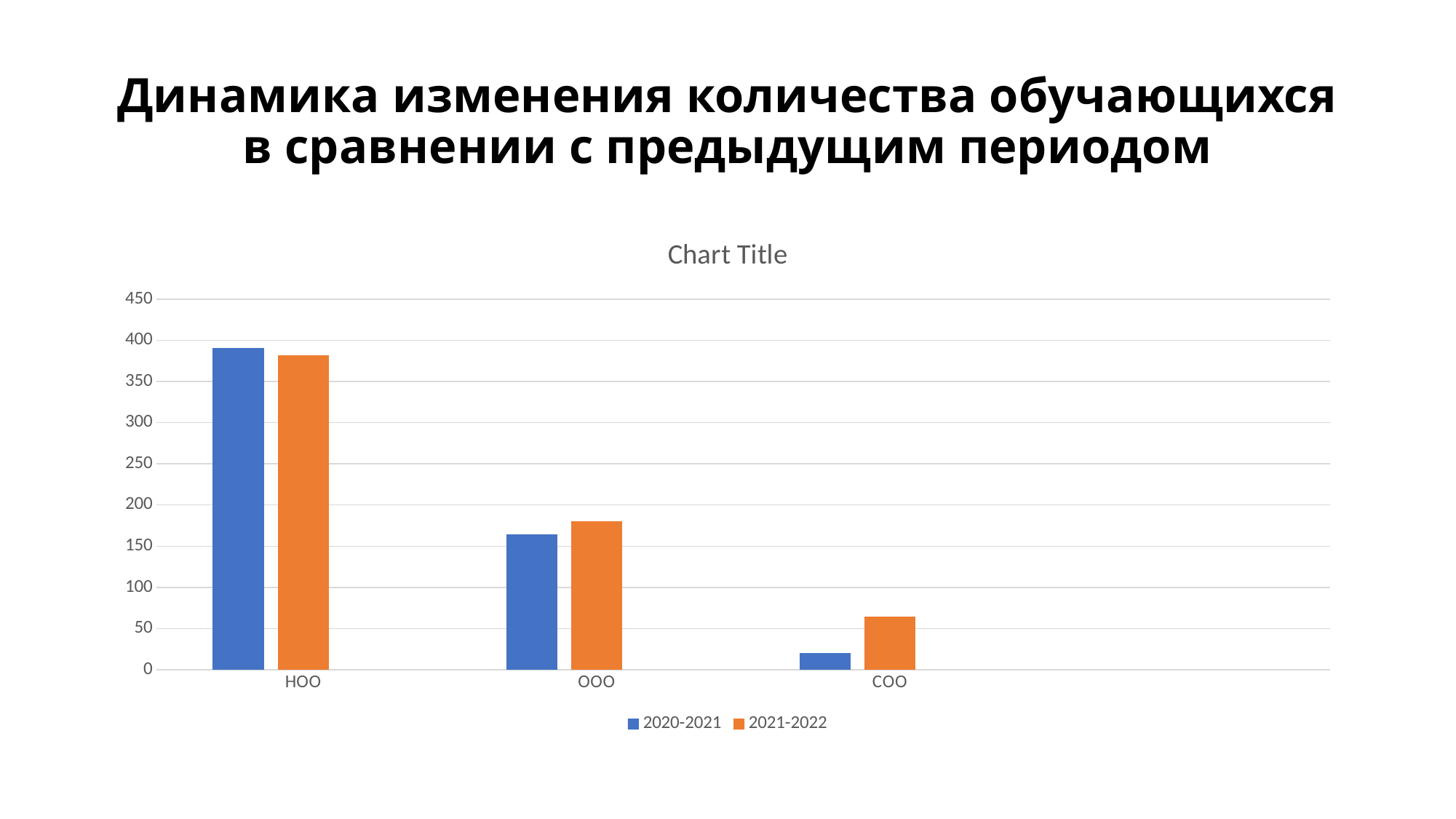
How many categories are shown on the x axis of the chart? 3 For the category ООО, which series has the larger value, 2020-2021 or 2021-2022? 2021-2022 Which category has the lowest value for the 2021-2022 series? СОО Is the value for ООО in the 2021-2022 series greater or less than 200? less Is the value for НОО in the 2020-2021 series greater or less than 350? greater Which category has the highest value for the 2020-2021 series? НОО For the category СОО, which series has the larger value, 2020-2021 or 2021-2022? 2021-2022 What kind of chart is shown on the slide? bar chart What are the two series names listed in the chart legend? 2020-2021 and 2021-2022 How many series does the chart legend list? 2 Is the value for СОО in the 2020-2021 series greater or less than 50? less Which category has the lowest value for the 2020-2021 series? СОО